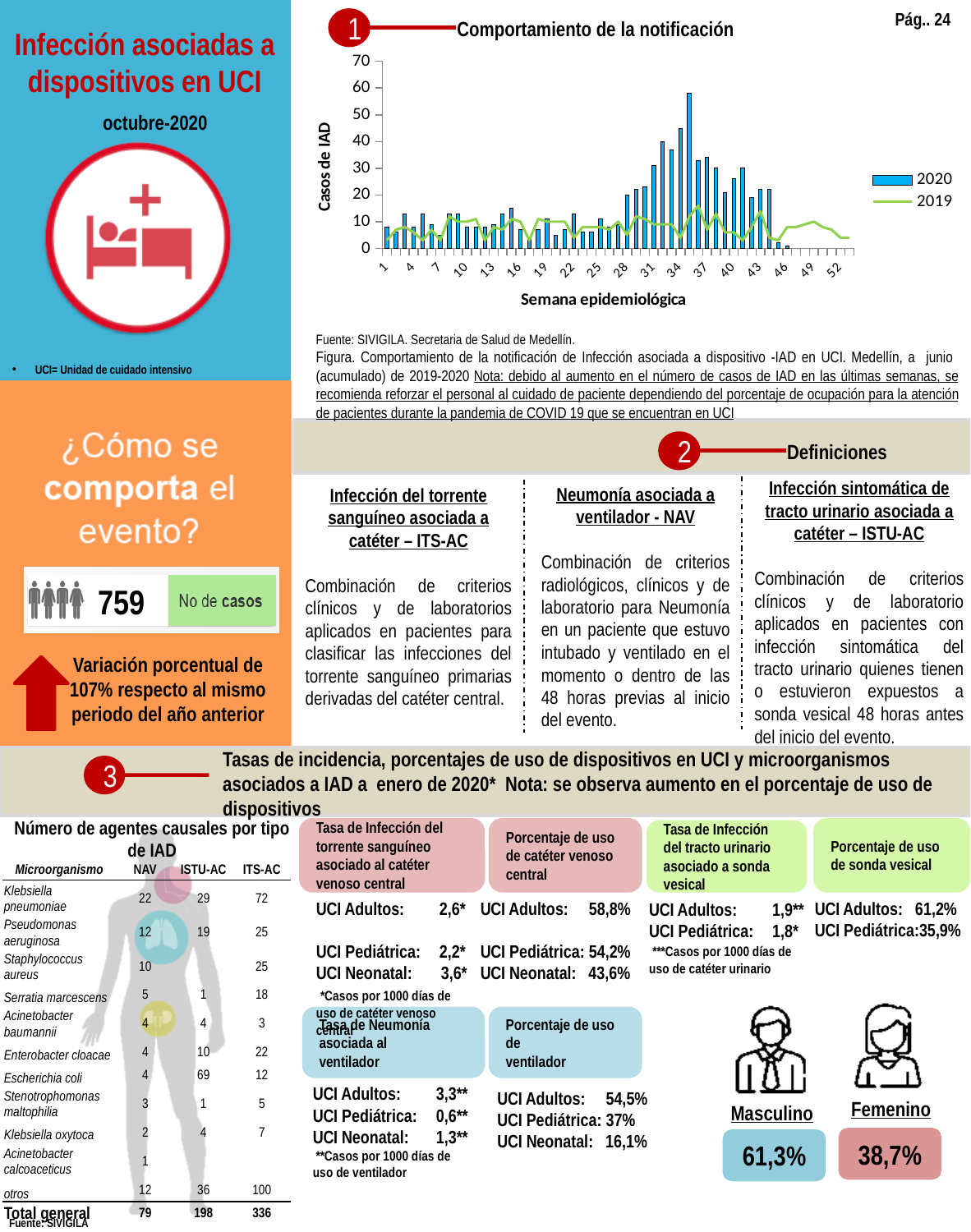
In the 'Comportamiento de la notificación' chart, is the highest 2020 bar greater or less than 50? greater In the 'Comportamiento de la notificación' chart, is the 2019 value at week 52 greater or less than 10? less In the 'Comportamiento de la notificación' chart, does the 2019 line ever rise above 20? No In the 'Comportamiento de la notificación' chart, which series reaches the highest value overall, 2020 or 2019? 2020 What are the two entries in the legend of the 'Comportamiento de la notificación' chart? 2020 and 2019 What kind of chart is used to plot the 2020 series in 'Comportamiento de la notificación'? bar chart What is the title of the x axis of the 'Comportamiento de la notificación' chart? Semana epidemiológica In the 'Comportamiento de la notificación' chart, which series has the larger value around week 35, 2020 or 2019? 2020 In the 'Comportamiento de la notificación' chart, do the 2020 bars rise or fall from week 37 to week 46? fall How many series does the legend of the 'Comportamiento de la notificación' chart list? 2